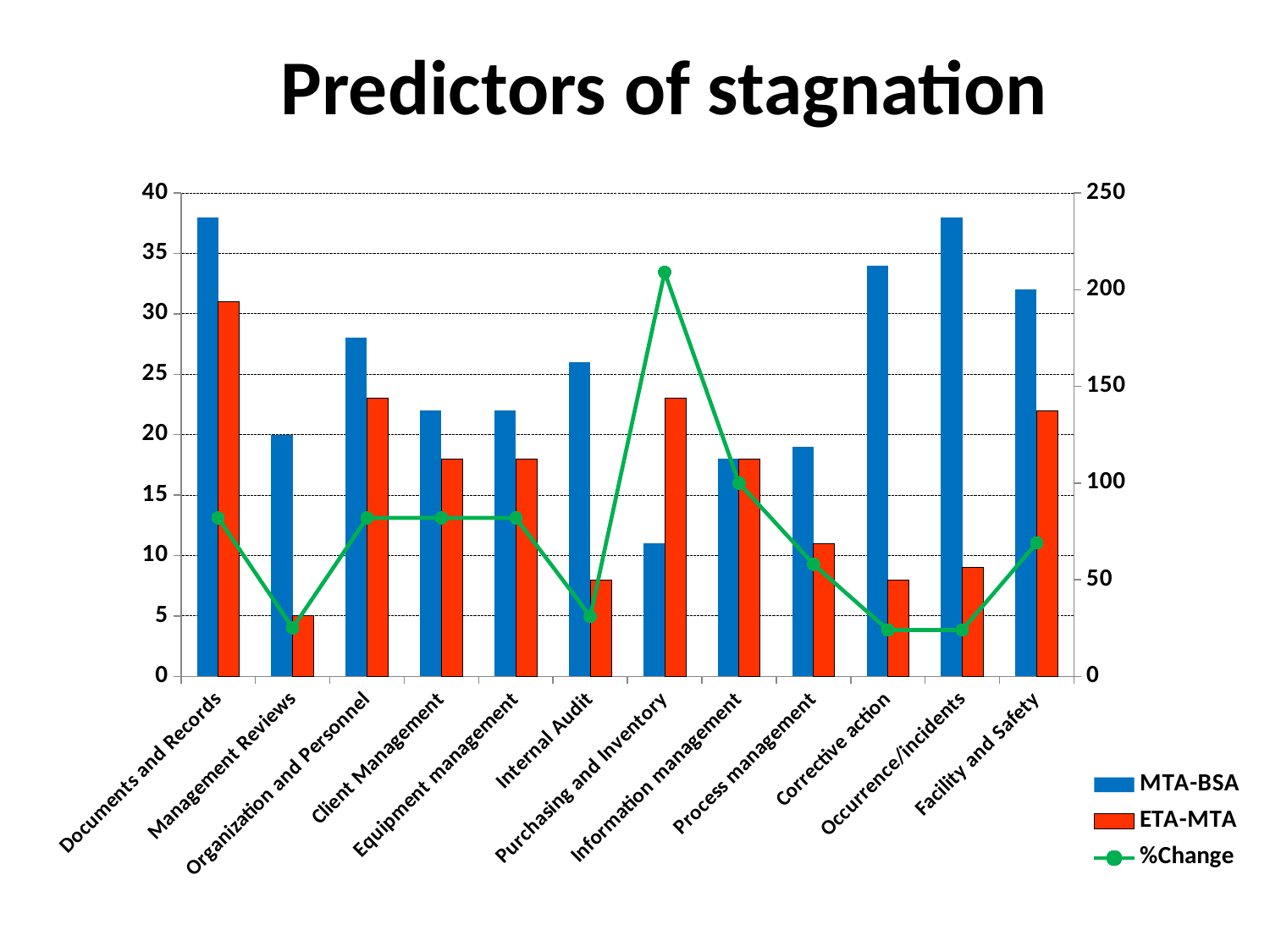
Is the ETA-MTA value for Internal Audit greater or less than 10? less What is the title of the chart? Predictors of stagnation Which category has the highest %Change value? Purchasing and Inventory Which category has the lowest MTA-BSA value? Purchasing and Inventory What is the ETA-MTA value for Management Reviews? 5 Which series is plotted as a green line with markers? %Change How many categories are shown along the x axis? 12 What kind of chart is shown on the slide? A combined bar and line chart What is the MTA-BSA value for Management Reviews? 20 Is the MTA-BSA value for Corrective action greater or less than 30? greater Which category has the highest ETA-MTA value? Documents and Records How many series does the legend list? 3